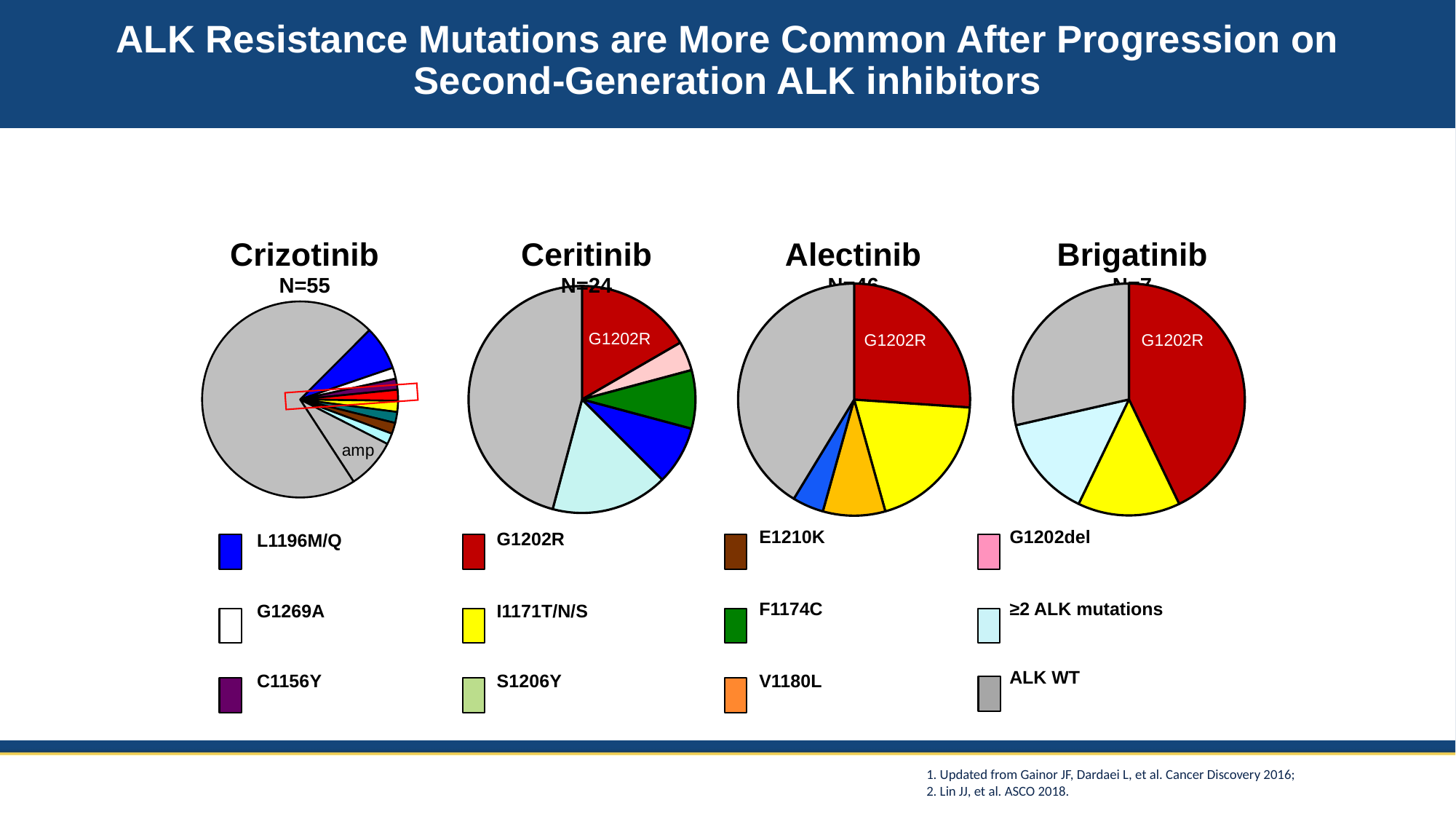
In the Brigatinib pie chart, which category has the largest slice? G1202R Which mutation is labelled directly on the Ceritinib, Alectinib and Brigatinib pie charts? G1202R In the Ceritinib pie chart, what is the N value shown under the title? N=24 What kind of charts are shown on the slide? Pie charts How many entries does the shared legend list? 12 In the Crizotinib pie chart, what is the N value shown under the title? N=55 In the Brigatinib pie chart, which slice is larger: G1202R or ALK WT? G1202R In the Alectinib pie chart, which category has the largest slice? ALK WT In the Crizotinib pie chart, which category has the largest slice? ALK WT In the Alectinib pie chart, which slice is larger: I1171T/N/S or V1180L? I1171T/N/S How many pie charts are shown on the slide? 4